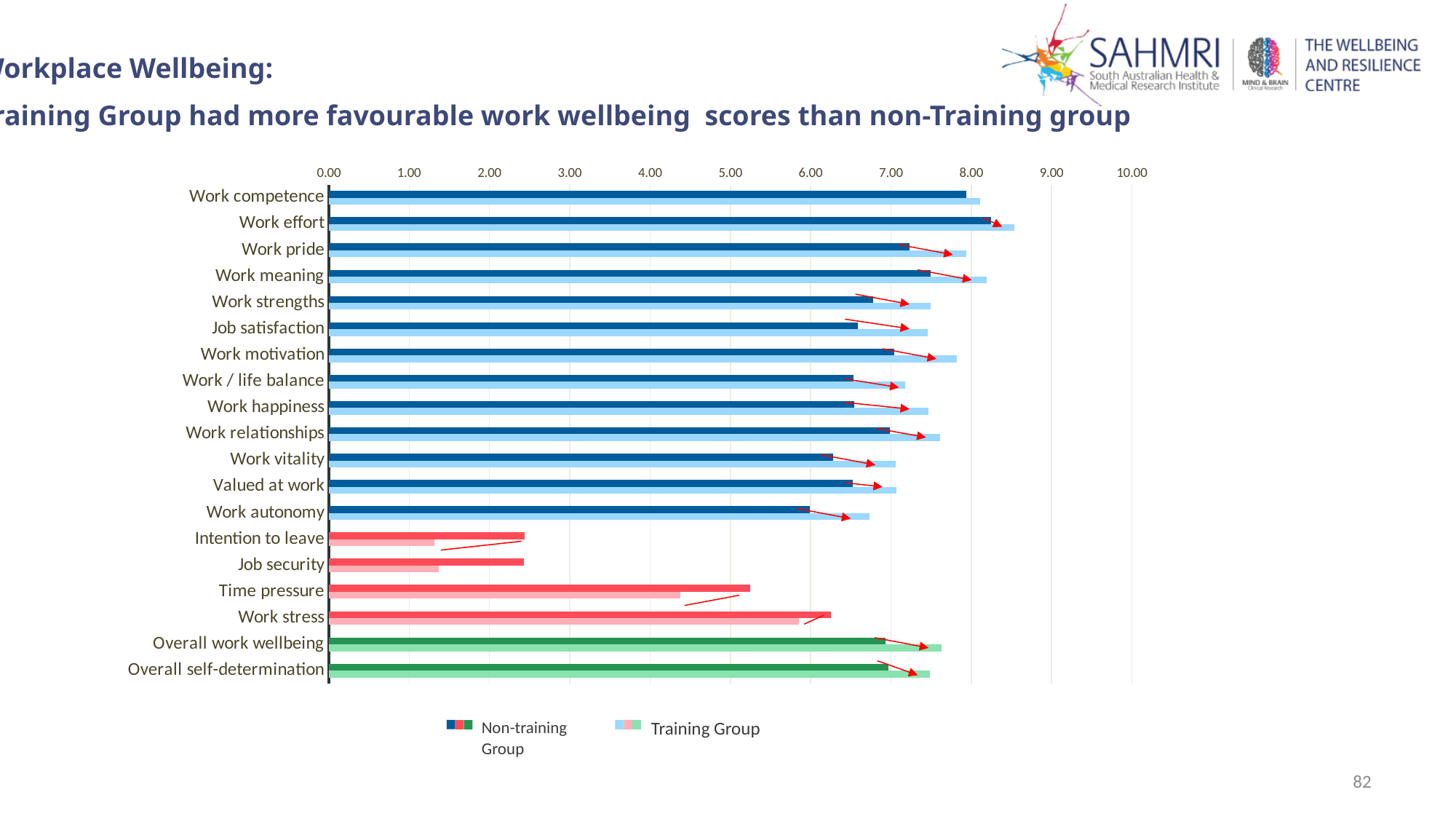
Which category has the highest value for the Training Group? Work effort What are the two series named in the legend? Non-training Group and Training Group Is the Training Group value for Intention to leave greater or less than 2.00? less Is the Non-training Group value for Work autonomy greater or less than 7.00? less For Intention to leave, which group has the larger value, Non-training Group or Training Group? Non-training Group For Work pride, which group has the larger value, Non-training Group or Training Group? Training Group How many series does the legend list? 2 Is the Training Group value for Work meaning greater or less than 8.00? greater What kind of chart is shown on the slide? Bar chart For Work stress, which group has the larger value, Non-training Group or Training Group? Non-training Group How many categories are plotted on the vertical axis of the chart? 19